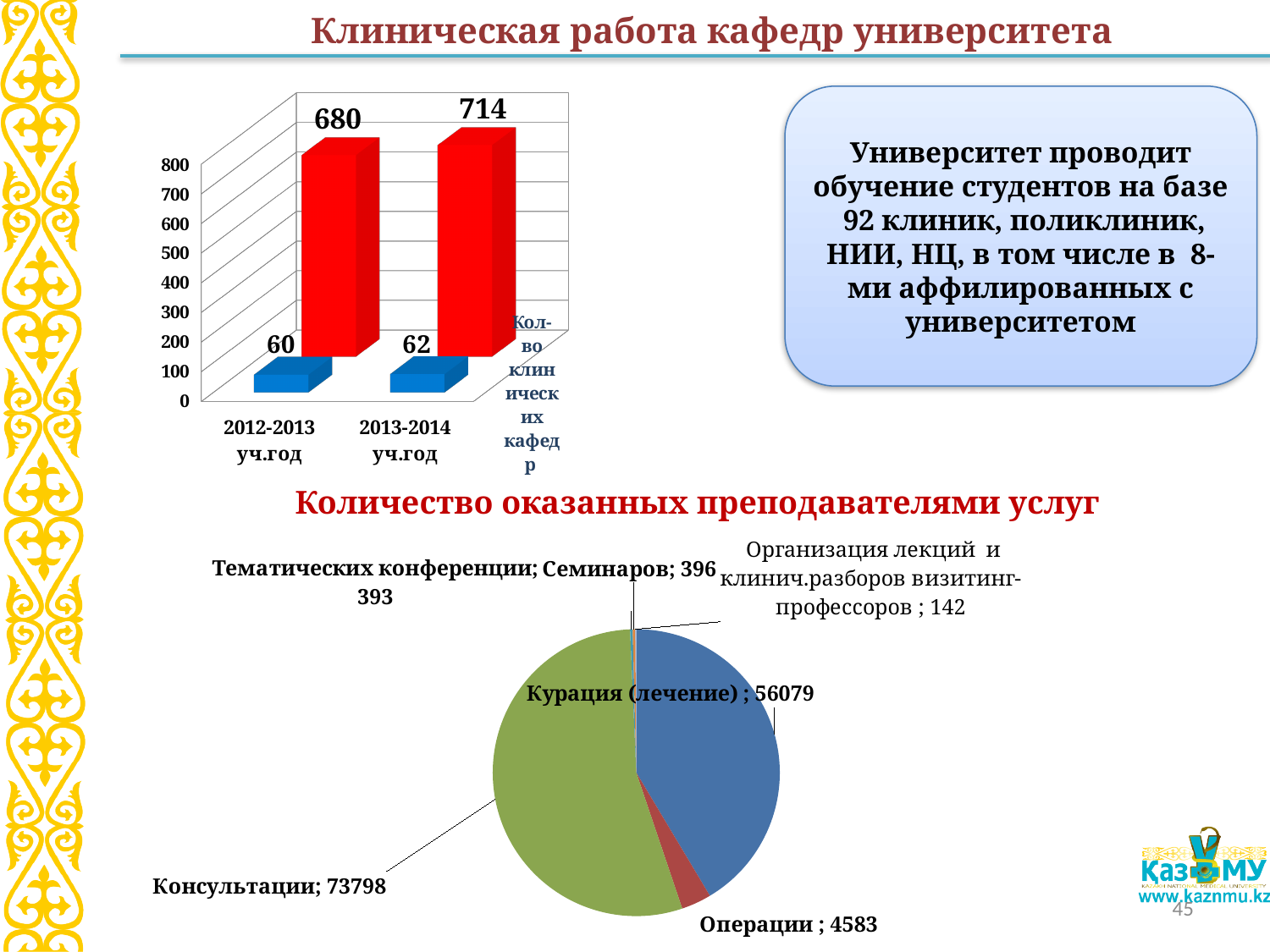
In the top-left bar chart, does the red series rise or fall from 2012-2013 уч.год to 2013-2014 уч.год? rise In the top-left bar chart, what is the difference between the red series values for 2013-2014 уч.год and 2012-2013 уч.год? 34 In the pie chart 'Количество оказанных преподавателями услуг', which is larger: Семинаров or Тематических конференции? Семинаров In the top-left bar chart, how many categories are shown on the x axis? 2 In the top-left bar chart, what is the value of the blue series for 2012-2013 уч.год? 60 In the pie chart 'Количество оказанных преподавателями услуг', which category has the smallest value? Организация лекций и клинич.разборов визитинг-профессоров What kind of chart is the top-left chart? bar chart In the top-left bar chart, what is the value of the red series for 2013-2014 уч.год? 714 In the pie chart 'Количество оказанных преподавателями услуг', what is the value for Операции? 4583 In the top-left bar chart, what is the value of the red series for 2012-2013 уч.год? 680 In the pie chart 'Количество оказанных преподавателями услуг', what is the value for Консультации? 73798 In the pie chart 'Количество оказанных преподавателями услуг', which category has the largest value? Консультации